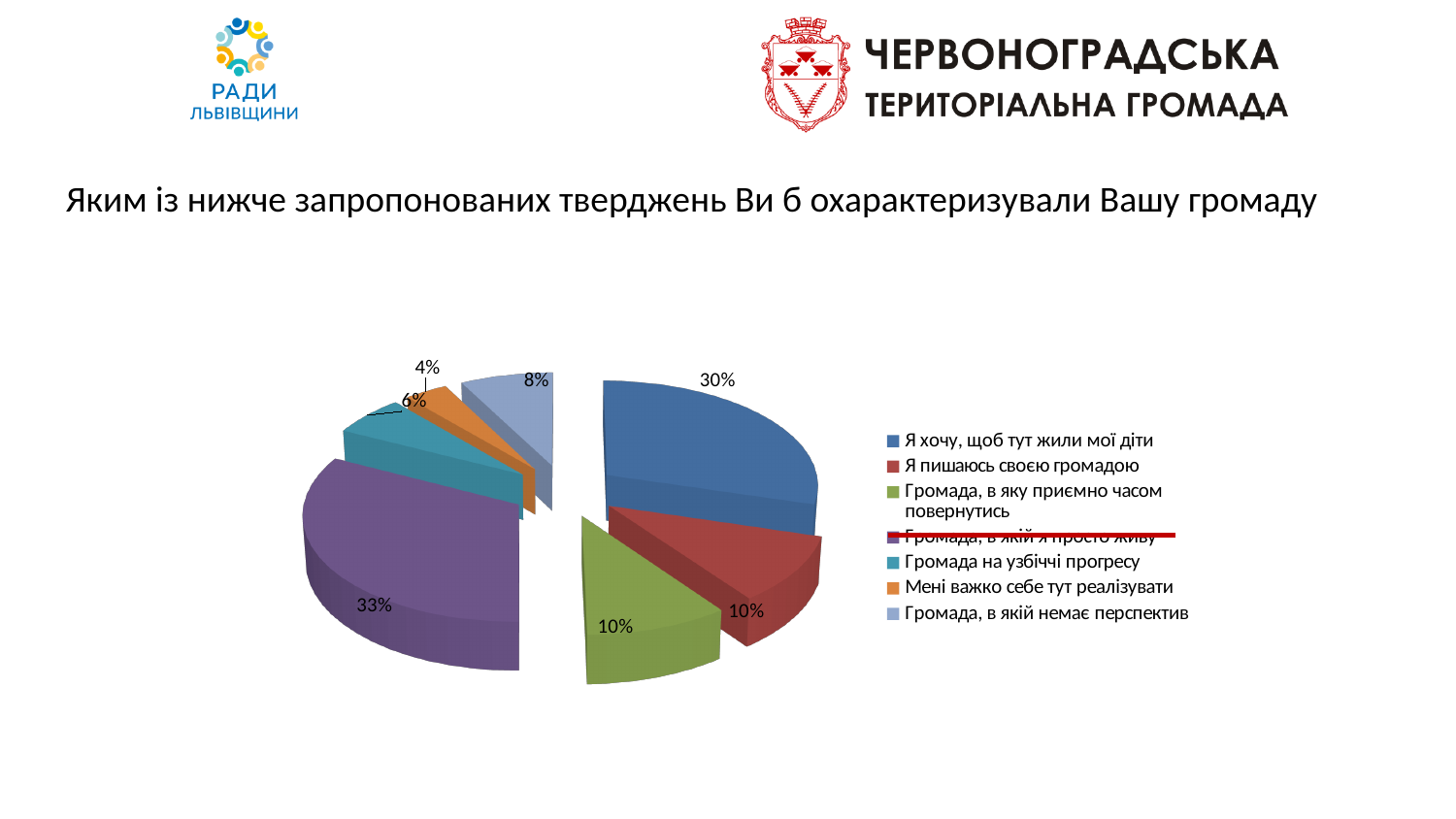
What is the difference between the share for "Я хочу, щоб тут жили мої діти" and the share for "Громада, в якій немає перспектив"? 22% What share of the pie is labelled for "Я пишаюсь своєю громадою"? 10% How many entries does the legend list? 7 What share of the pie is labelled for "Мені важко себе тут реалізувати"? 4% What share of the pie is labelled for "Громада, в якій немає перспектив"? 8% What type of chart is shown on the slide? pie chart What is the largest percentage shown on the pie chart? 33% What share of the pie is labelled for "Громада на узбіччі прогресу"? 6% Which legend entry has the smallest slice of the pie? Мені важко себе тут реалізувати Which is larger: the share for "Громада на узбіччі прогресу" or the share for "Громада, в якій немає перспектив"? Громада, в якій немає перспектив How many slices does the pie chart have? 7 What share of the pie is labelled for "Я хочу, щоб тут жили мої діти"? 30%